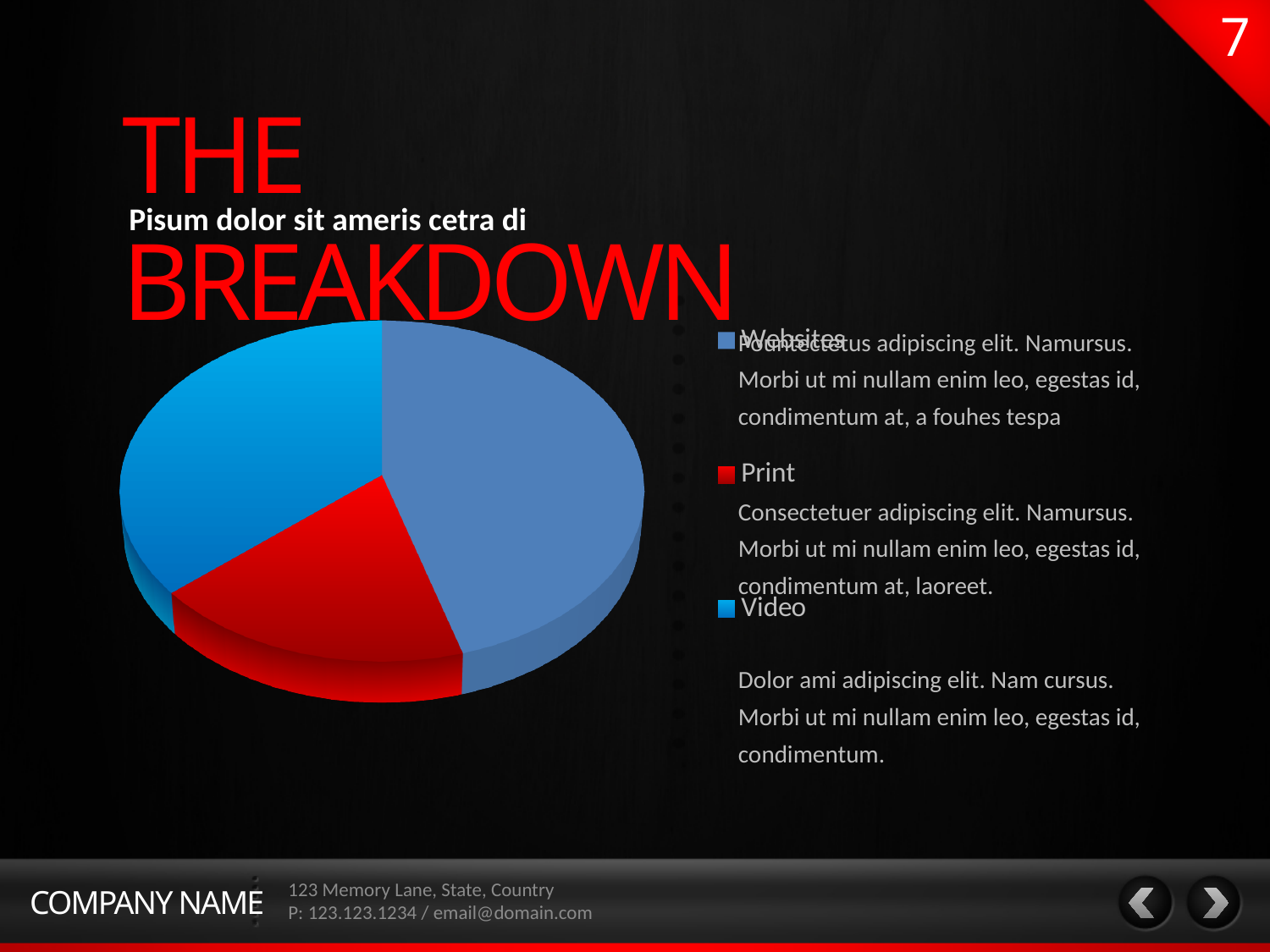
Which category has the largest slice of the pie chart? Websites Which slice is larger, Websites or Print? Websites Which category has the smallest slice of the pie chart? Print How many slices does the pie chart have? 3 Which slice is larger, Video or Print? Video What kind of chart is shown on the slide? pie chart What colour is the Print slice in the pie chart? red What are the three categories listed in the chart legend? Websites, Print, Video Which slice is larger, Websites or Video? Websites How many entries does the chart legend list? 3